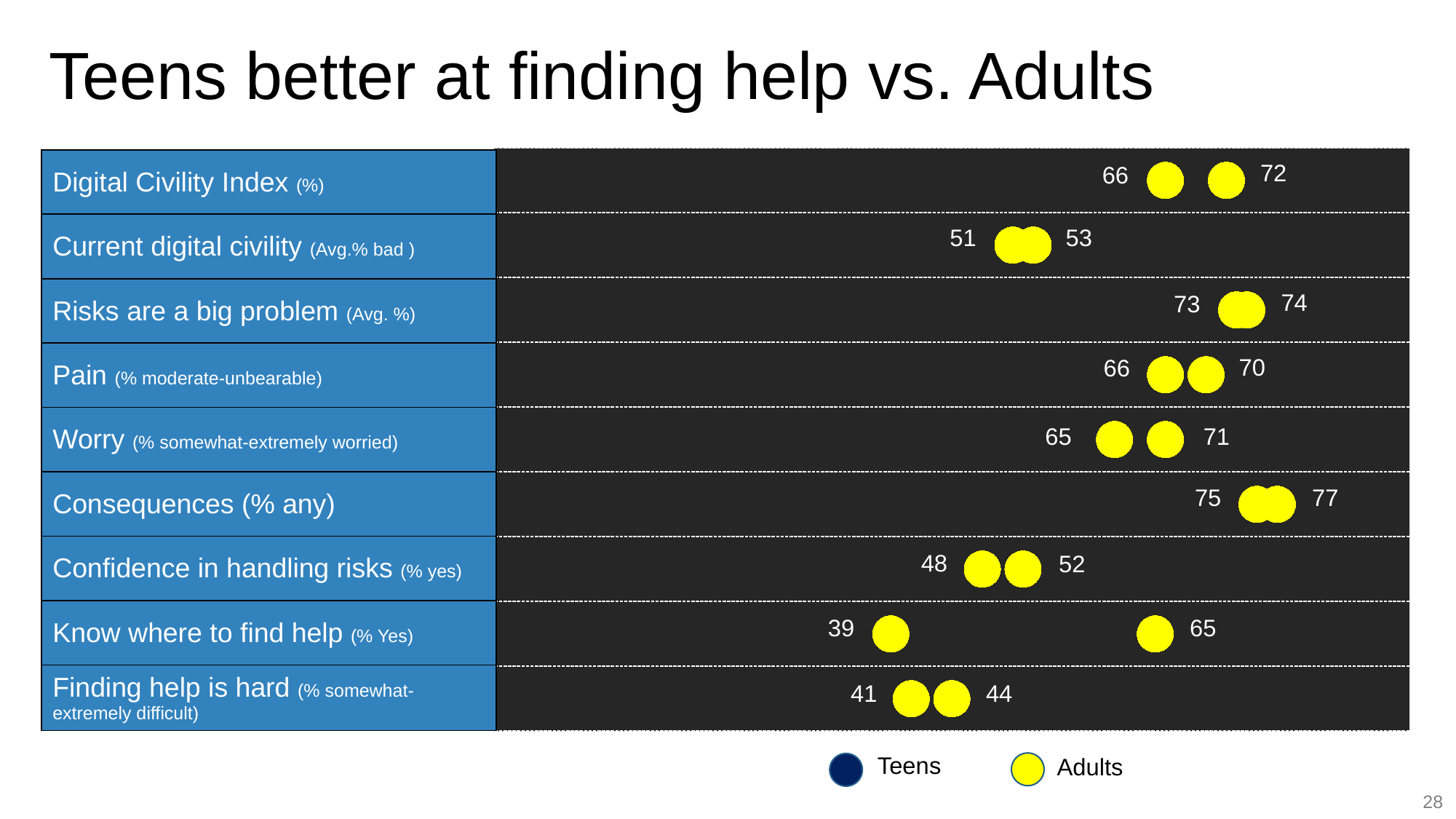
What is the lower of the two values plotted for Finding help is hard? 41 How many series does the legend list? 2 How many categories (rows) are plotted in the chart? 9 What are the two values plotted for Worry? 65 and 71 What kind of chart is shown on the slide? dot plot What is the difference between the two values plotted for Digital Civility Index? 6 What are the two series named in the legend? Teens and Adults Which category contains the lowest plotted value in the chart? Know where to find help What is the difference between the two values plotted for Know where to find help? 26 Which category contains the highest plotted value in the chart? Consequences (% any) What are the two values plotted for Digital Civility Index? 66 and 72 What is the higher of the two values plotted for Consequences (% any)? 77